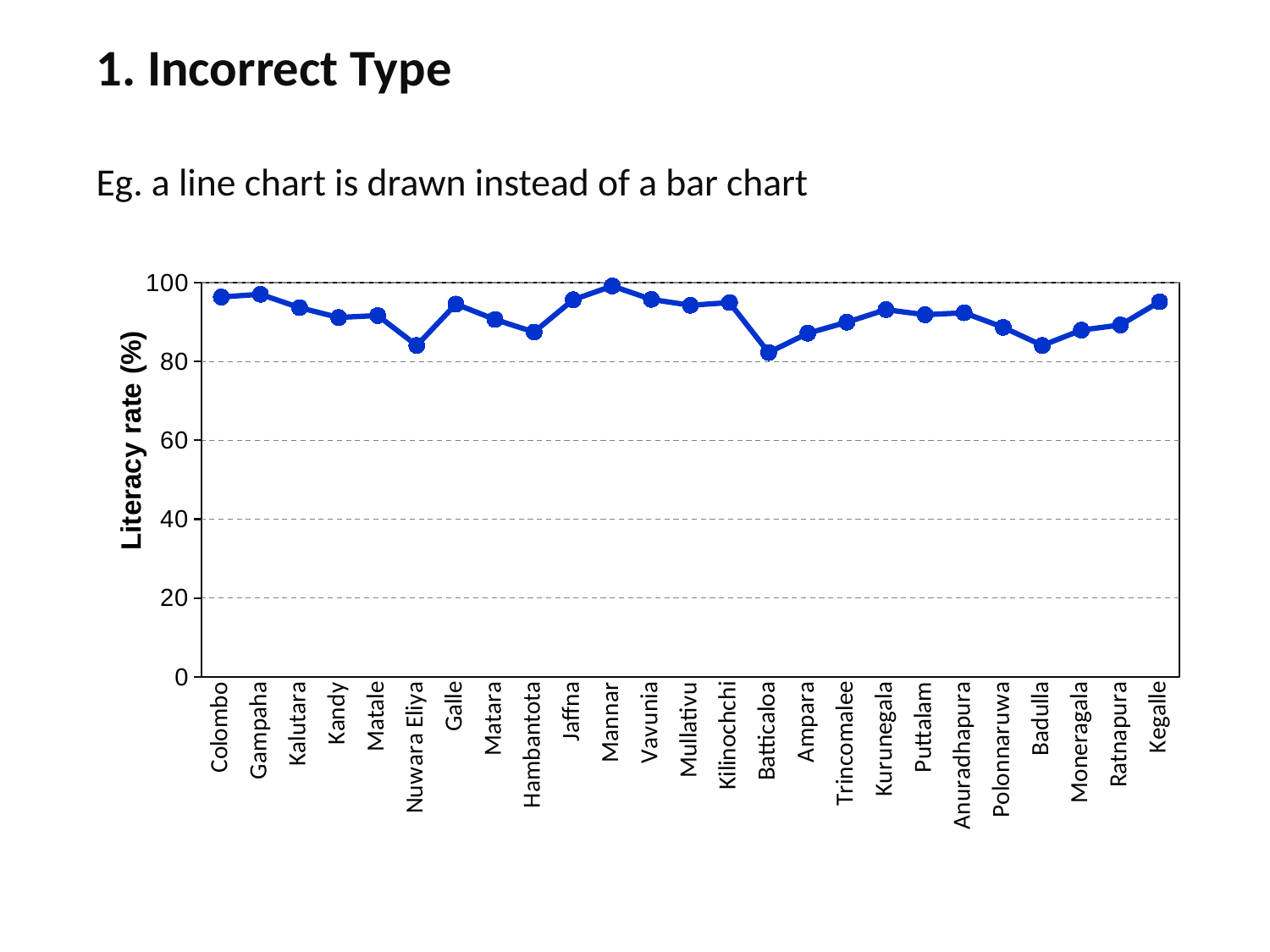
Is the literacy rate for Badulla greater or less than 100? less What kind of chart is shown on the slide? line chart Is the literacy rate for Kandy greater or less than 60? greater Which has a higher literacy rate, Gampaha or Nuwara Eliya? Gampaha What is the label of the y axis of the chart? Literacy rate (%) What is the first district listed on the x axis of the chart? Colombo Which district has the lowest literacy rate in the chart? Batticaloa Is the literacy rate for Colombo greater or less than 80? greater How many districts are plotted along the x axis of the chart? 25 Which has a higher literacy rate, Mannar or Batticaloa? Mannar Which has a higher literacy rate, Galle or Hambantota? Galle Which district has the highest literacy rate in the chart? Mannar